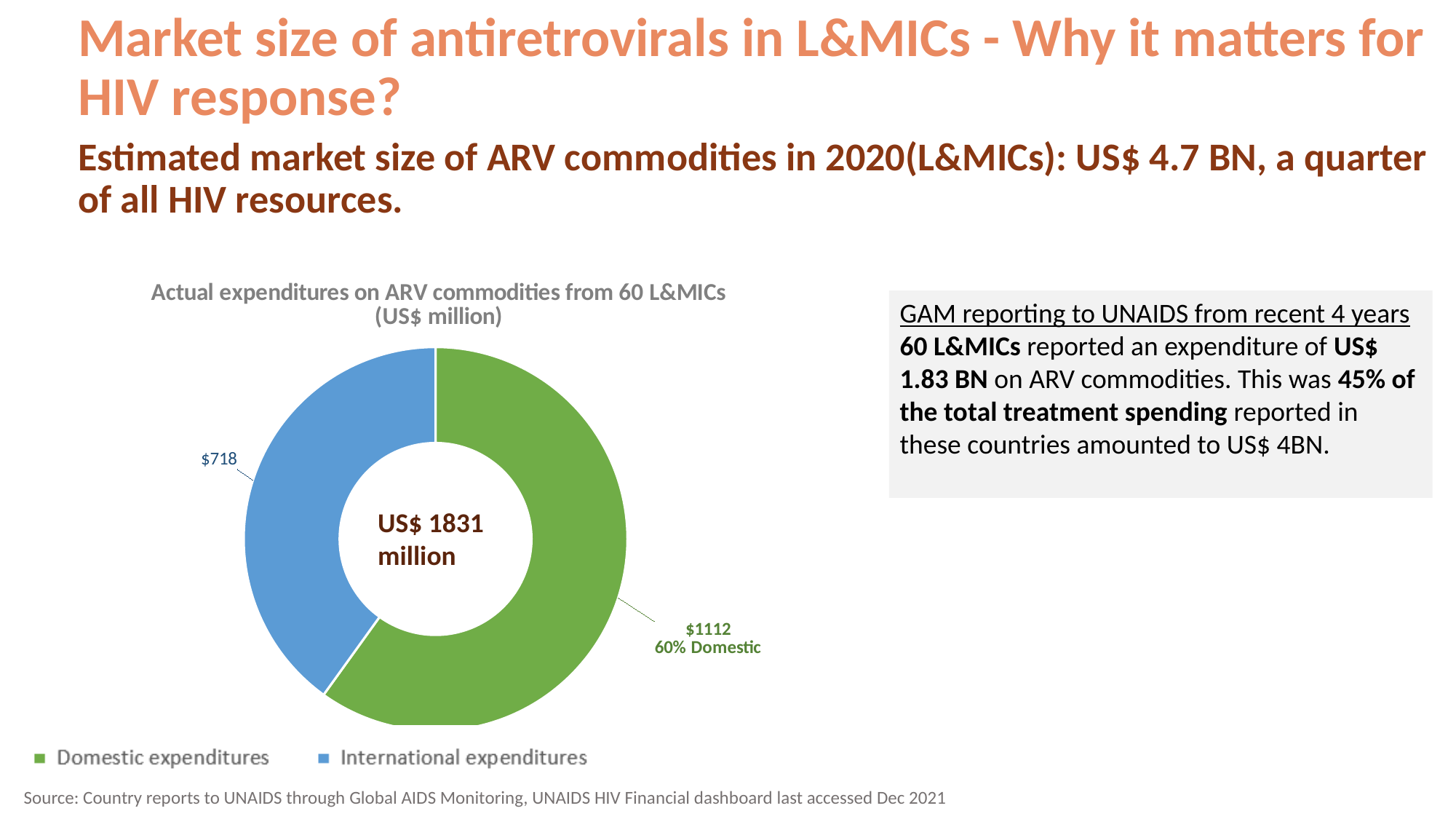
How many categories does the chart show? 2 What is the difference between Domestic expenditures and International expenditures? $394 What is the value for Domestic expenditures? $1112 What colour represents International expenditures in the chart? Blue Which category has the highest value? Domestic expenditures What share of the total do Domestic expenditures represent? 60% What kind of chart is shown on the slide? Doughnut (pie) chart What is the total shown in the centre of the chart? US$ 1831 million Which is larger, Domestic expenditures or International expenditures? Domestic expenditures What is the title of the chart? Actual expenditures on ARV commodities from 60 L&MICs (US$ million) What is the value for International expenditures? $718 Which category has the lowest value? International expenditures